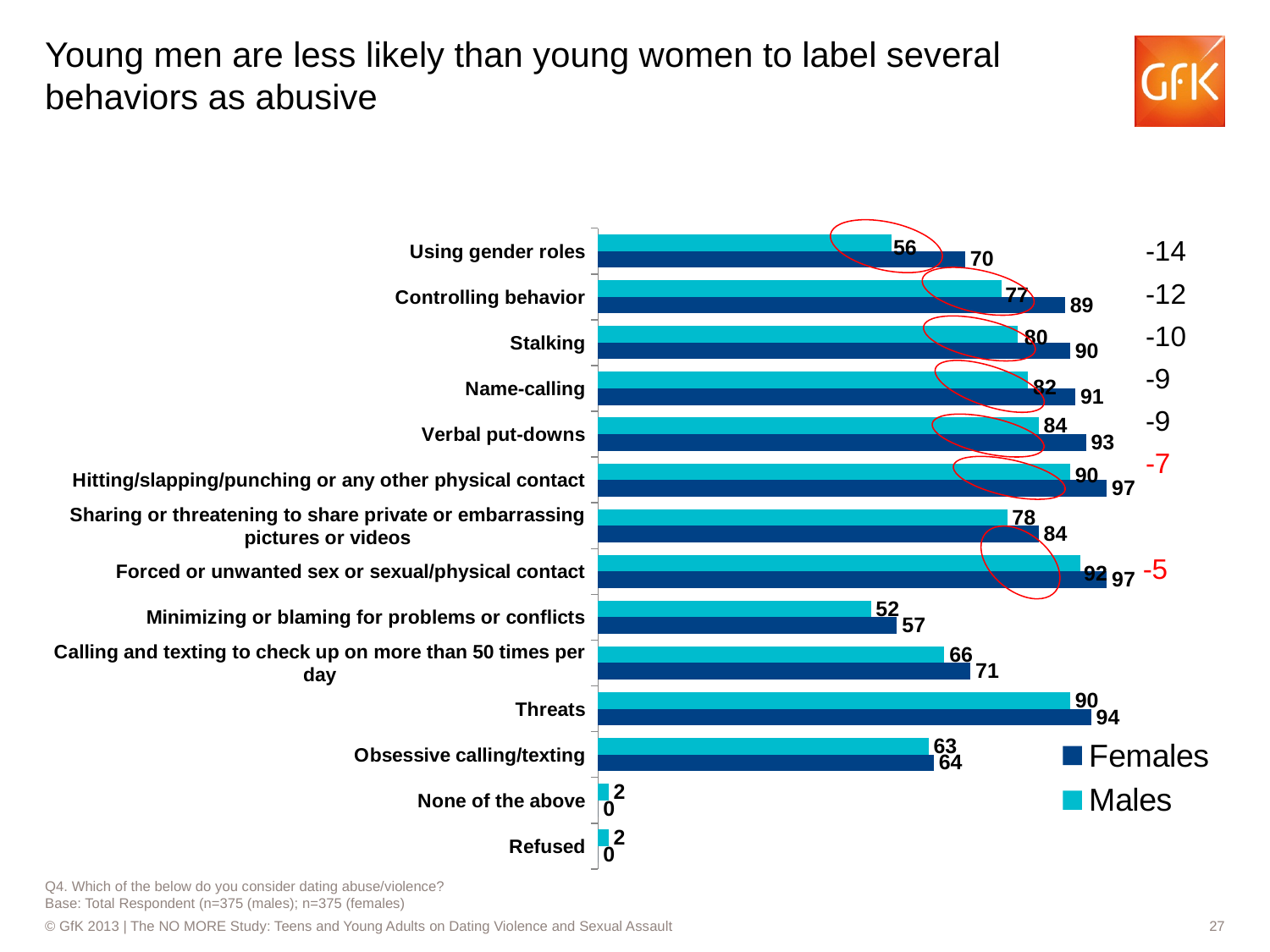
What percentage of males consider using gender roles to be dating abuse? 56 Which category has the highest value for males? Forced or unwanted sex or sexual/physical contact Which series is shown in dark blue in the legend? Females What is the value for females for Controlling behavior? 89 What kind of chart is shown on the slide? Bar chart For Stalking, which is larger: the value for males or the value for females? Females What is the difference between the female and male values for Using gender roles? 14 What is the value for males for Minimizing or blaming for problems or conflicts? 52 How many categories are shown on the chart? 14 Excluding None of the above and Refused, which category has the lowest value for females? Minimizing or blaming for problems or conflicts How many series does the legend list? 2 What is the value for females for Threats? 94